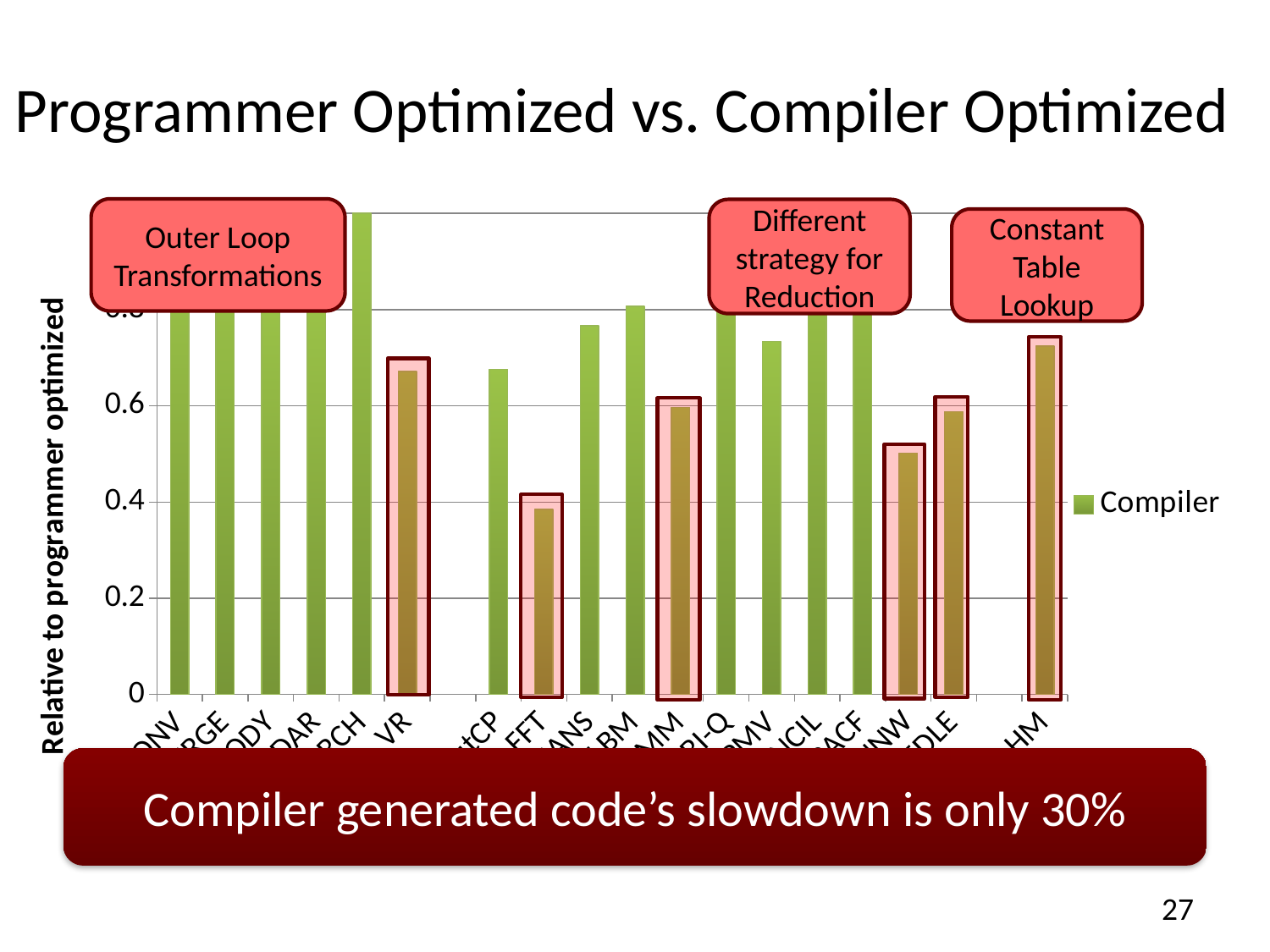
Which category has the lowest bar in the chart? FFT How many bars are plotted in the chart? 18 Is the value for VR greater or less than 0.6? greater Which has the larger value, FFT or VR? VR Is the value for HM greater or less than 0.6? greater Which has the larger value, HM or FFT? HM What kind of chart is shown on the slide? bar chart Is the value for FFT greater or less than 0.2? greater How many series does the chart legend list? 1 What is the name of the series shown in the chart legend? Compiler What is the label of the vertical axis? Relative to programmer optimized